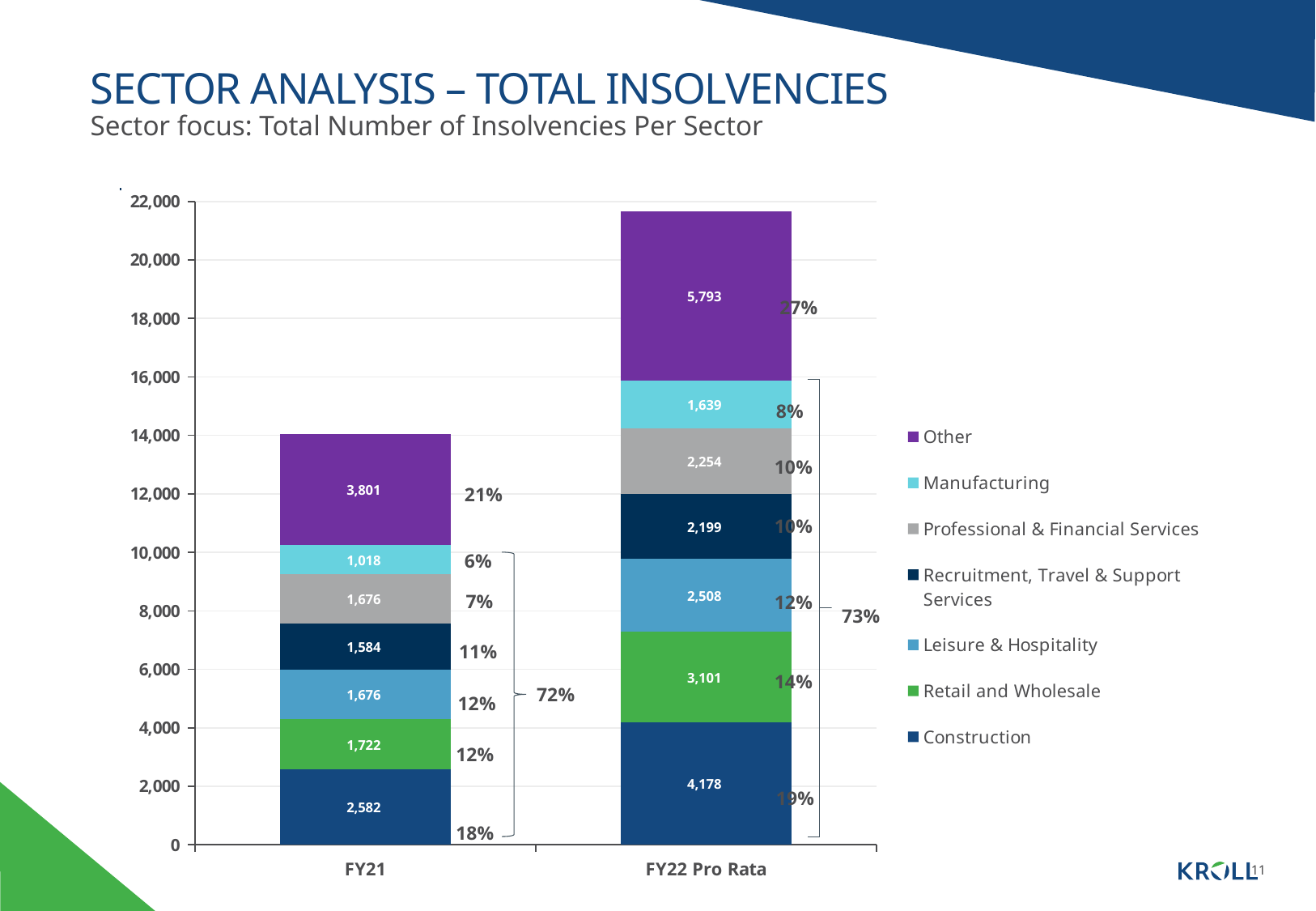
What percentage label is shown next to the Other segment in FY21? 21% What is the total of the FY22 Pro Rata stacked bar? 21,672 What is the value for Construction in FY21? 2,582 What is the value for Retail and Wholesale in FY22 Pro Rata? 3,101 Which is larger, the Leisure & Hospitality value in FY21 or in FY22 Pro Rata? FY22 Pro Rata What is the value for Manufacturing in FY21? 1,018 How many categories are shown on the x axis? 2 What is the value for Other in FY22 Pro Rata? 5,793 What is the total of the FY21 stacked bar? 14,059 What kind of chart is shown on the slide? Stacked bar chart How many series does the legend list? 7 What is the difference between the Construction values for FY22 Pro Rata and FY21? 1,596